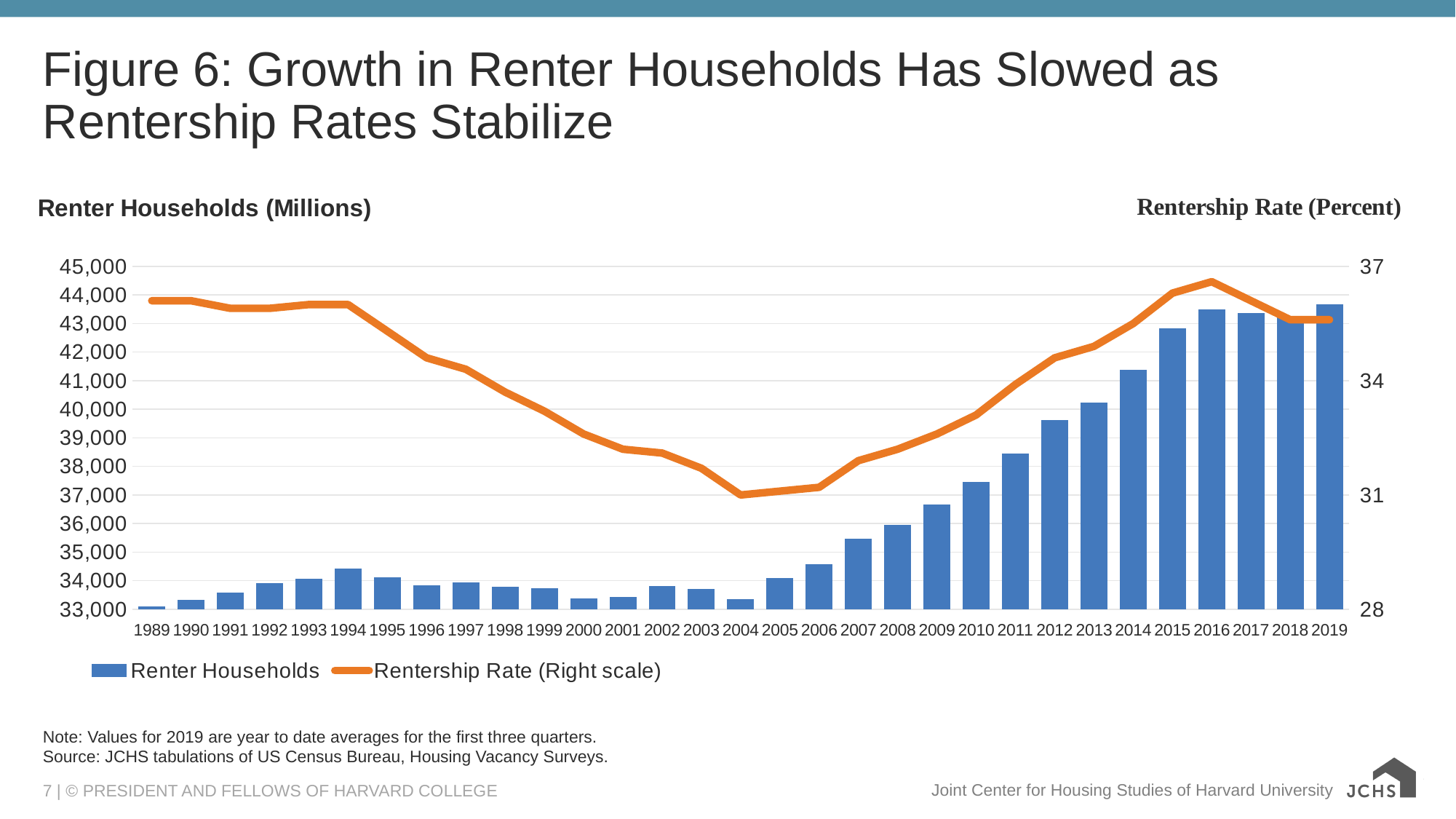
Is the Renter Households value for 2004 greater or less than 34,000? less Which year has the highest Renter Households bar? 2019 In which year does the Rentership Rate line reach its lowest point? 2004 Which year has the lowest Renter Households bar? 1989 How many years are shown along the x axis? 31 In which year does the Rentership Rate line reach its highest point? 2016 How many series does the legend list? 2 Does the Rentership Rate line rise or fall between 1994 and 2004? fall What is the title of the left vertical axis? Renter Households (Millions) What kind of chart is shown on the slide? A combination bar and line chart Is the Renter Households value for 2016 greater or less than 43,000? greater Is the Rentership Rate for 2004 greater or less than 34? less